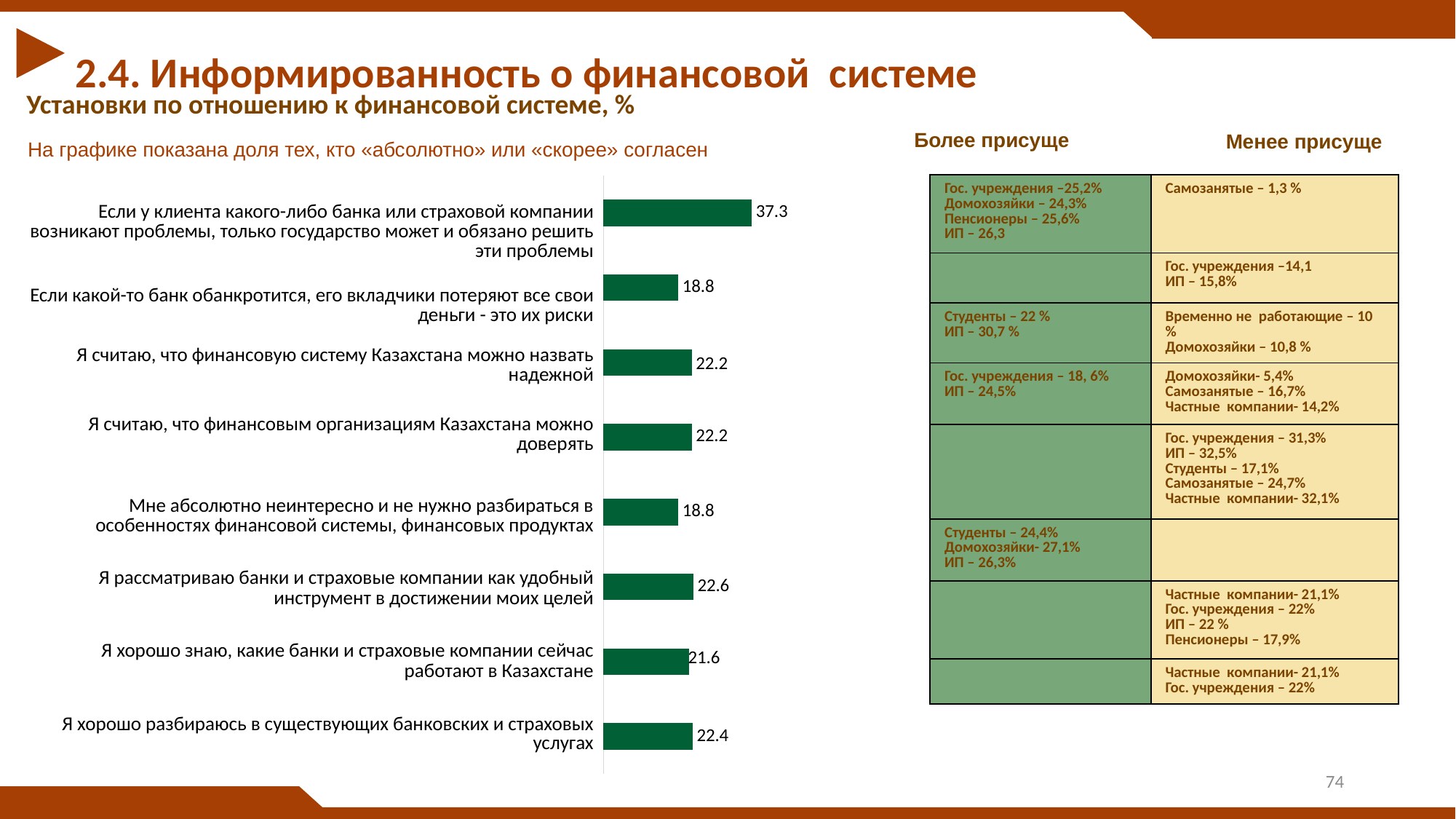
What is the lowest value shown in the chart? 18.8 What is the difference between the values for "Я хорошо разбираюсь в существующих банковских и страховых услугах" and "Мне абсолютно неинтересно и не нужно разбираться в особенностях финансовой системы, финансовых продуктах"? 3.6 What is the subtitle of the chart section on the slide? Установки по отношению к финансовой системе, % Which statement has the highest value in the chart? Если у клиента какого-либо банка или страховой компании возникают проблемы, только государство может и обязано решить эти проблемы How many statements (categories) are plotted in the bar chart? 8 What kind of chart is shown on the slide? bar chart What is the value for the statement "Если у клиента какого-либо банка или страховой компании возникают проблемы, только государство может и обязано решить эти проблемы"? 37.3 What is the difference between the highest value (37.3) and the value for "Если какой-то банк обанкротится, его вкладчики потеряют все свои деньги - это их риски"? 18.5 What is the value for "Я рассматриваю банки и страховые компании как удобный инструмент в достижении моих целей"? 22.6 Which is larger: the value for "Я рассматриваю банки и страховые компании как удобный инструмент в достижении моих целей" or for "Я хорошо знаю, какие банки и страховые компании сейчас работают в Казахстане"? Я рассматриваю банки и страховые компании как удобный инструмент в достижении моих целей What is the value for "Я хорошо знаю, какие банки и страховые компании сейчас работают в Казахстане"? 21.6 What is the value for "Я хорошо разбираюсь в существующих банковских и страховых услугах"? 22.4